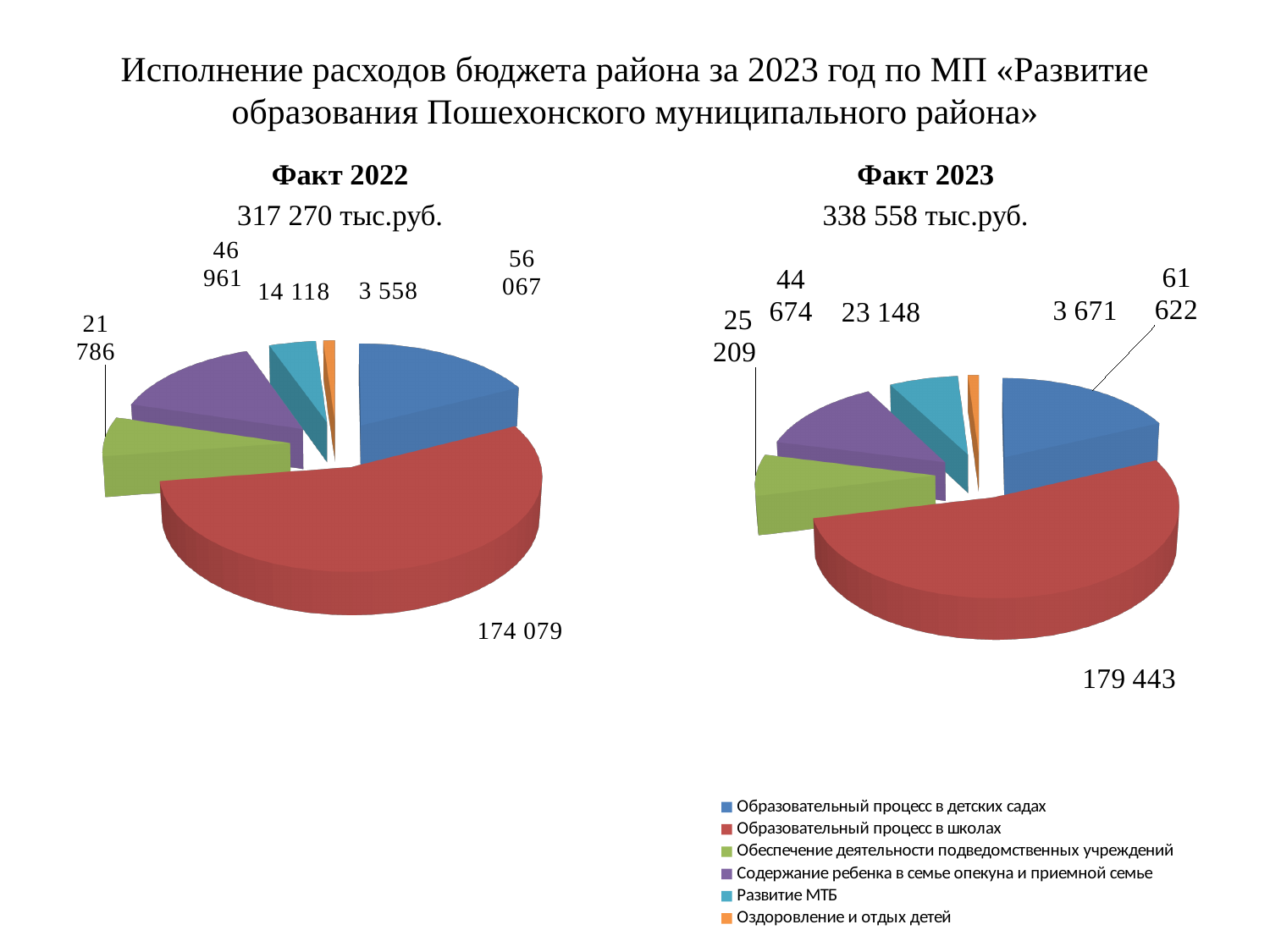
In the Факт 2022 chart, what is the value for Образовательный процесс в школах? 174 079 In the Факт 2023 chart, what is the value for Развитие МТБ? 23 148 Which colour represents Развитие МТБ in the legend? Cyan (light blue) What total amount is shown under the Факт 2023 chart title? 338 558 тыс.руб. What type of chart is the Факт 2022 chart? Pie chart How many categories does the legend list? 6 In the Факт 2022 chart, which category has the smallest slice? Оздоровление и отдых детей In the Факт 2023 chart, which category has the largest slice? Образовательный процесс в школах In the Факт 2022 chart, what is the value for Содержание ребенка в семье опекуна и приемной семье? 46 961 In the Факт 2023 chart, which is larger: Обеспечение деятельности подведомственных учреждений or Содержание ребенка в семье опекуна и приемной семье? Содержание ребенка в семье опекуна и приемной семье What is the difference between the value for Образовательный процесс в школах in the Факт 2023 chart and in the Факт 2022 chart? 5 364 In the Факт 2023 chart, what is the value for Образовательный процесс в детских садах? 61 622